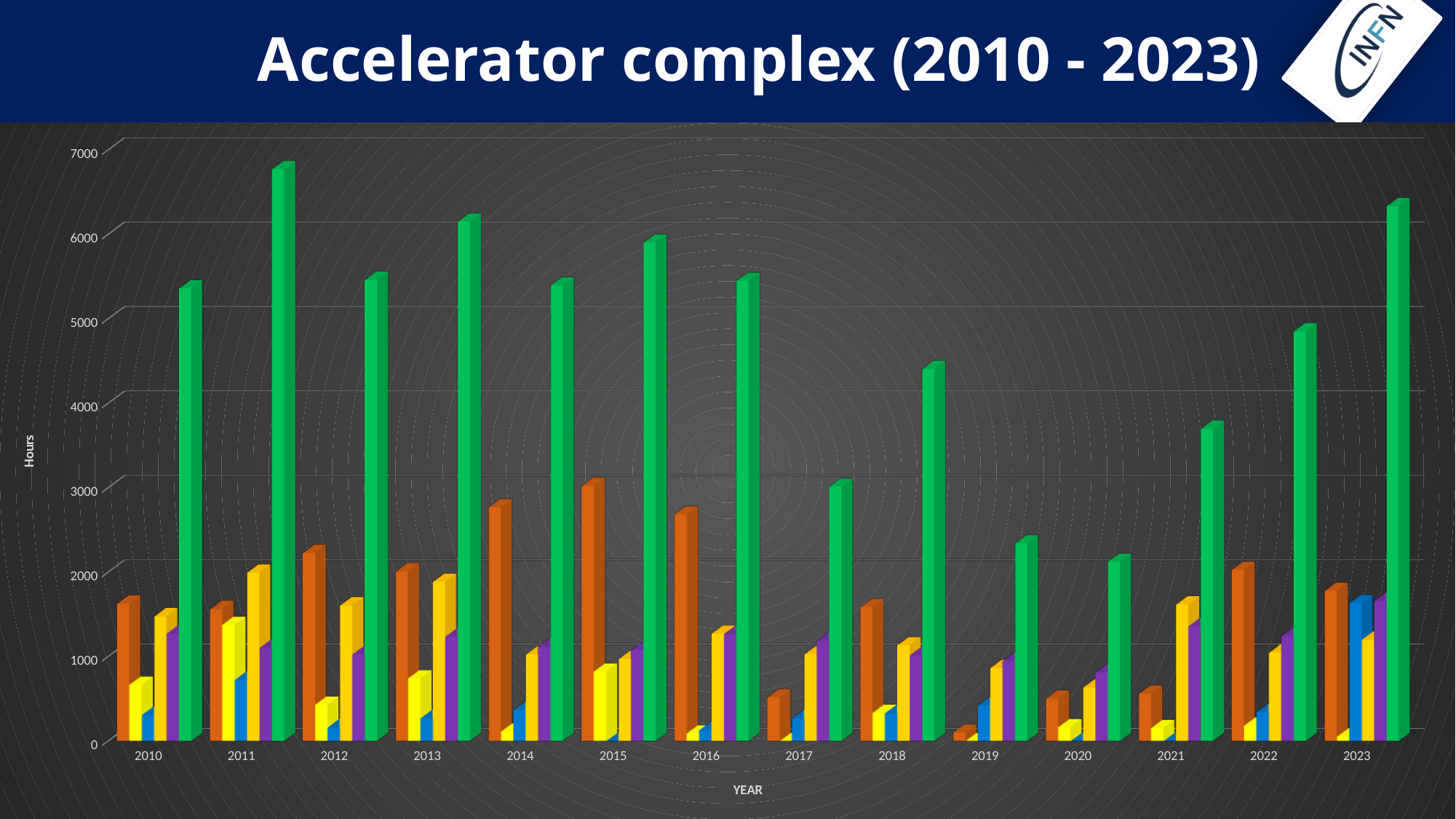
In which year is the green bar the tallest? 2011 Which is taller, the green bar for 2011 or the green bar for 2023? 2011 Is the green bar for 2011 greater or less than 6000? greater How many years are shown along the x axis of the chart? 14 What is the label of the vertical axis of the chart? Hours Is the green bar for 2023 greater or less than 6000? greater What is the title of the chart on the slide? Accelerator complex (2010 - 2023) How many bars are plotted for each year in the chart? 6 Is the orange bar for 2019 greater or less than 1000? less Do the green bars rise or fall from 2020 to 2023? rise What kind of chart is shown on the slide? bar chart